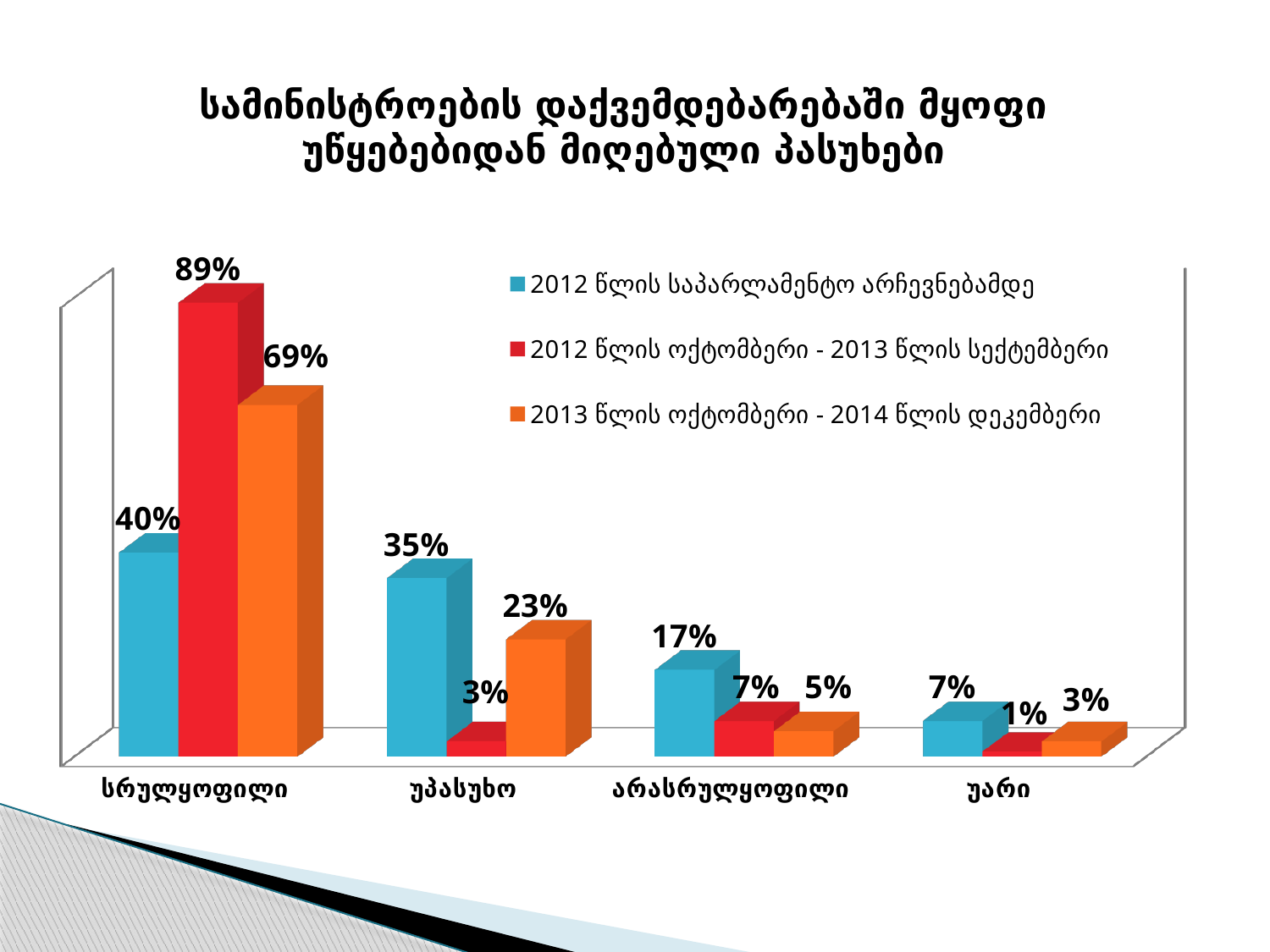
Which category has the lowest value in the series 2012 წლის ოქტომბერი - 2013 წლის სექტემბერი? უარი What is the value for სრულყოფილი in the series 2012 წლის ოქტომბერი - 2013 წლის სექტემბერი? 89% How many categories are shown on the x axis? 4 Do the values for the series 2012 წლის საპარლამენტო არჩევნებამდე rise or fall from left to right across the categories? Fall For არასრულყოფილი, which series has the larger value: 2012 წლის საპარლამენტო არჩევნებამდე or 2013 წლის ოქტომბერი - 2014 წლის დეკემბერი? 2012 წლის საპარლამენტო არჩევნებამდე What is the difference between the 2012 წლის ოქტომბერი - 2013 წლის სექტემბერი value and the 2012 წლის საპარლამენტო არჩევნებამდე value for სრულყოფილი? 49% How many series does the legend list? 3 What kind of chart is shown on the slide? Bar chart What is the value for უპასუხო in the series 2012 წლის საპარლამენტო არჩევნებამდე? 35% Which category has the highest value in the series 2013 წლის ოქტომბერი - 2014 წლის დეკემბერი? სრულყოფილი What is the value for უარი in the series 2013 წლის ოქტომბერი - 2014 წლის დეკემბერი? 3% Which colour represents the series 2012 წლის ოქტომბერი - 2013 წლის სექტემბერი? Red